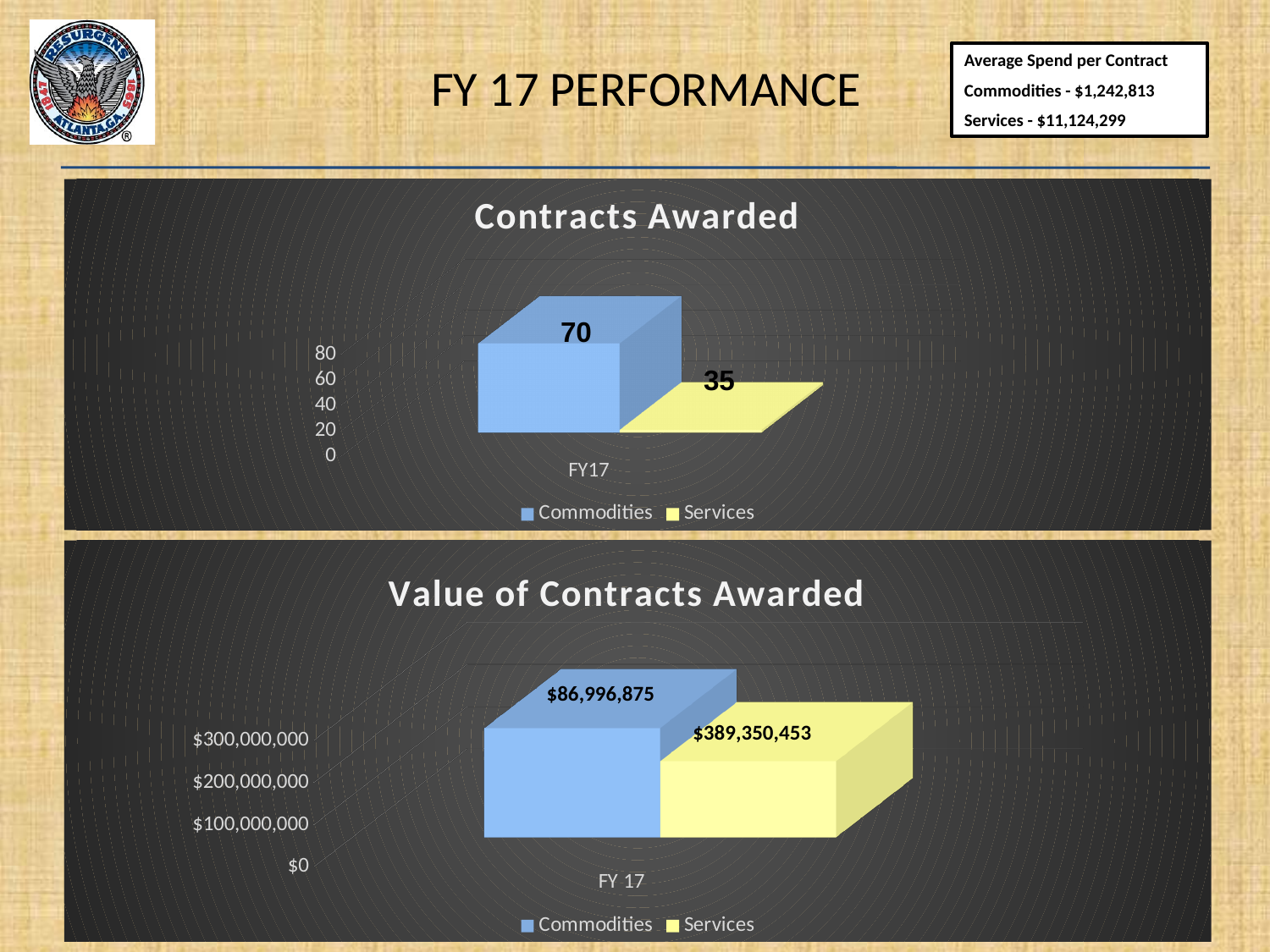
In the 'Value of Contracts Awarded' chart, what colour represents Services in the legend? Yellow In the 'Value of Contracts Awarded' chart, what is the value for Services? $389,350,453 In the 'Value of Contracts Awarded' chart, what category label appears on the x axis? FY 17 In the 'Value of Contracts Awarded' chart, which series has the larger value, Commodities or Services? Services In the 'Contracts Awarded' chart, what is the difference between the Commodities and Services values? 35 In the 'Contracts Awarded' chart, how many series does the legend list? 2 In the 'Contracts Awarded' chart, how many contracts were awarded for Commodities in FY17? 70 What kind of chart is the 'Contracts Awarded' chart? Bar chart In the 'Contracts Awarded' chart, how many contracts were awarded for Services in FY17? 35 In the 'Contracts Awarded' chart, which series has the higher value? Commodities In the 'Value of Contracts Awarded' chart, what is the value for Commodities? $86,996,875 In the 'Value of Contracts Awarded' chart, what is the difference between the Services and Commodities values? $302,353,578